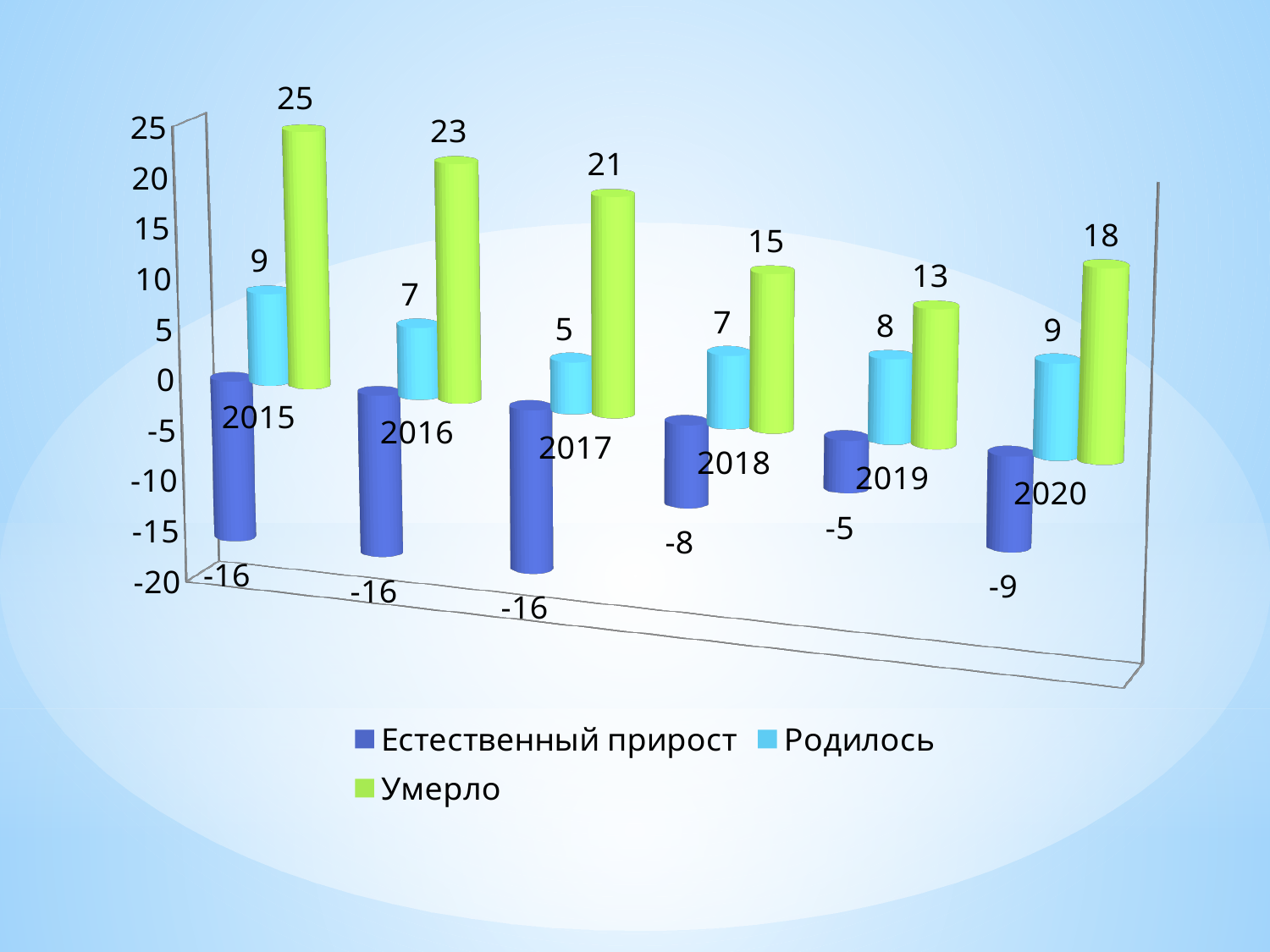
Does the Умерло value rise or fall from 2015 to 2019? Fall What is the value of Естественный прирост for 2019? -5 What is the value of Умерло for 2015? 25 What kind of chart is shown on the slide? Bar chart In which year is the Умерло value highest? 2015 What is the difference between Умерло and Родилось in 2018? 8 In which year is the Родилось value lowest? 2017 Which is larger in 2019: Родилось or Умерло? Умерло How many series does the legend list? 3 What is the value of Умерло for 2020? 18 What is the value of Родилось for 2017? 5 How many years are shown on the x axis? 6